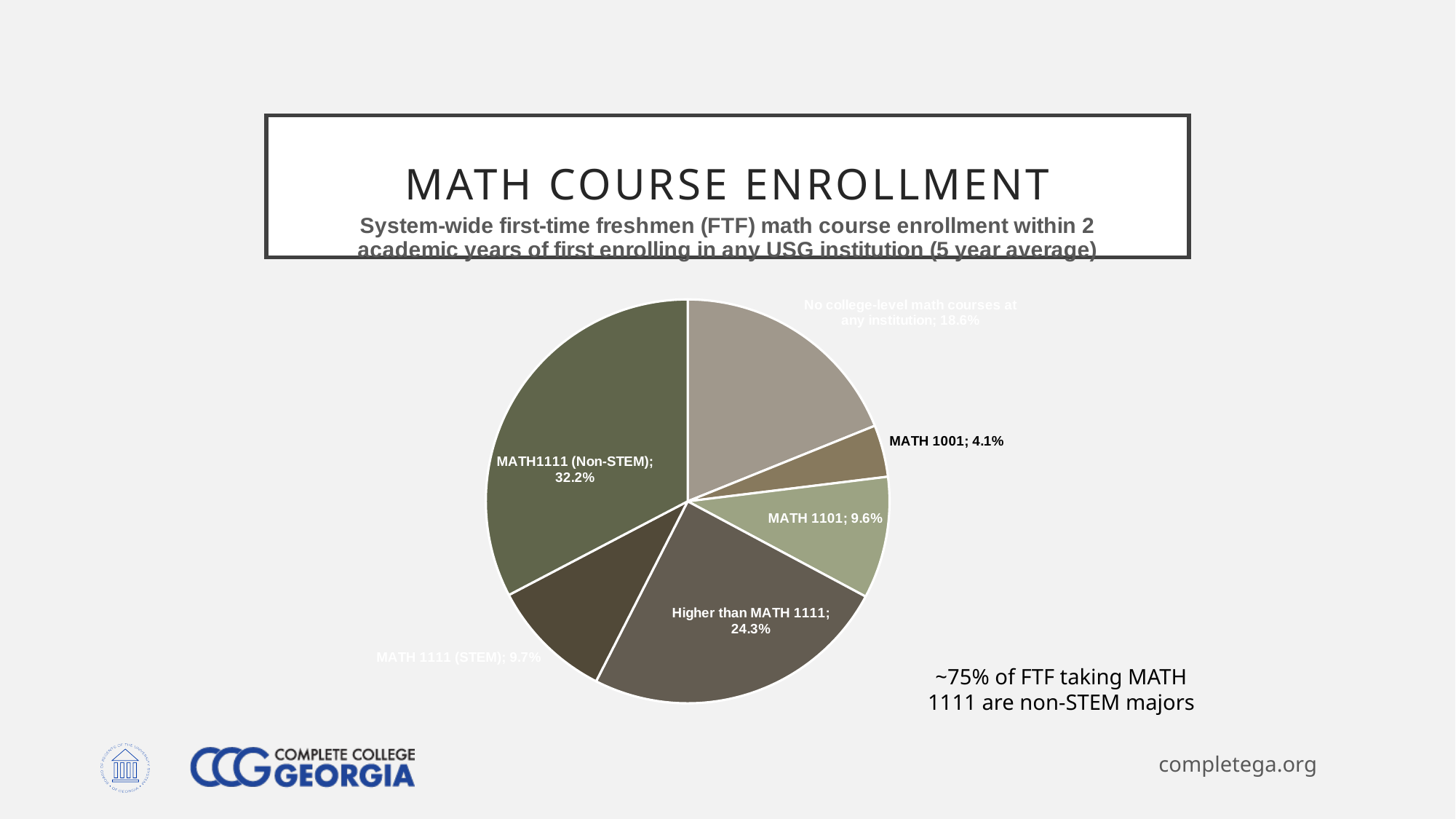
What share of the pie is labelled 'Higher than MATH 1111'? 24.3% What is the title of the slide containing the pie chart? MATH COURSE ENROLLMENT What kind of chart is shown on the slide? pie chart Which is larger: the share for MATH 1101 or the share for MATH 1001? MATH 1101 What percentage of FTF enrolled in MATH 1001? 4.1% How many slices does the pie chart have? 6 What percentage of FTF enrolled in MATH 1101? 9.6% What is the difference in percentage points between MATH1111 (Non-STEM) and Higher than MATH 1111? 7.9 Which category has the smallest slice of the pie? MATH 1001 What is the combined percentage of MATH 1111 (STEM) and MATH1111 (Non-STEM)? 41.9% Which category has the largest slice of the pie? MATH1111 (Non-STEM) What percentage is shown for MATH1111 (Non-STEM)? 32.2%